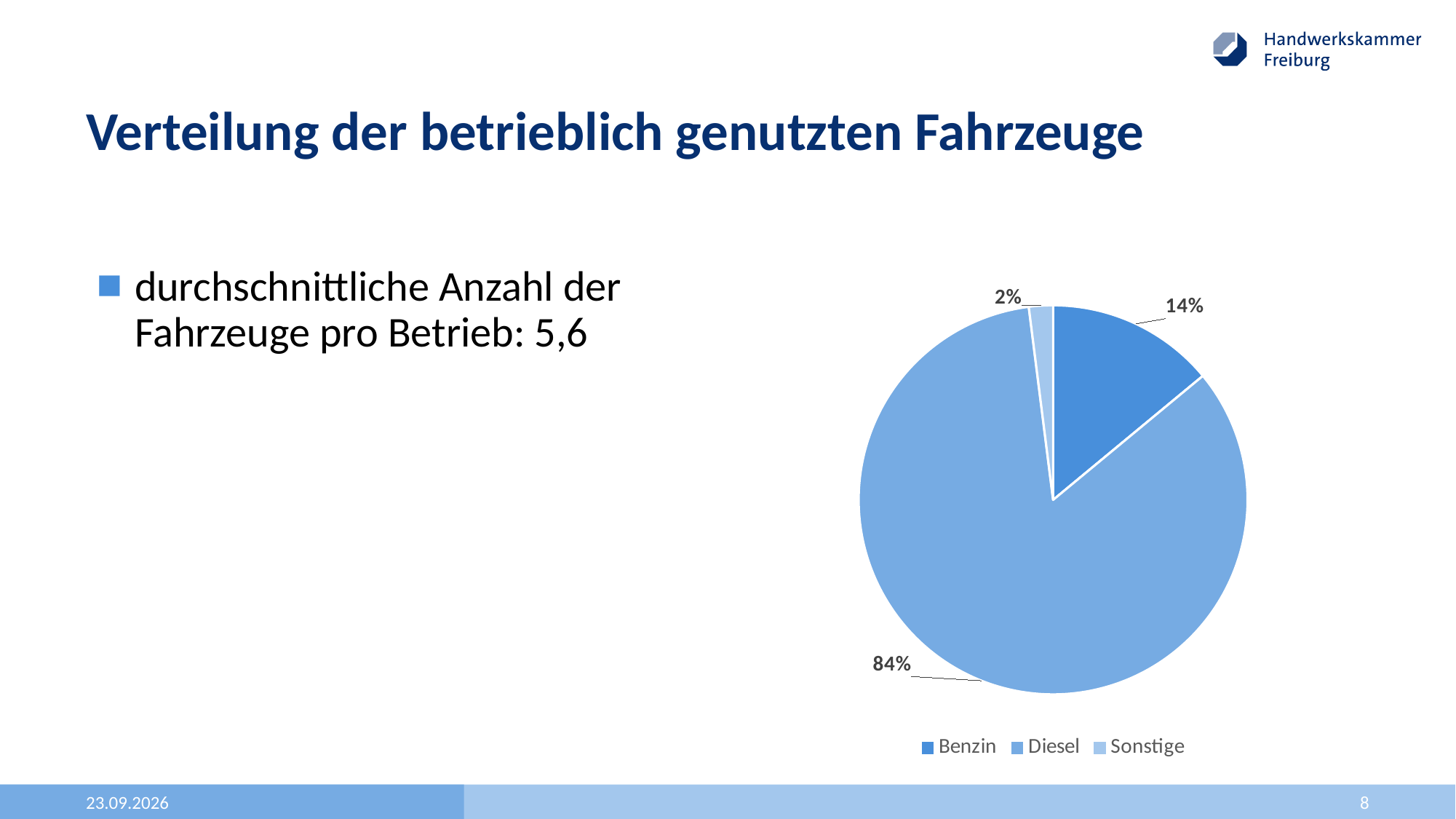
How many categories does the pie chart show? 3 What share of the pie does Benzin account for? 14% What are the three legend entries of the chart? Benzin, Diesel, Sonstige Which category has the smallest slice of the pie? Sonstige What kind of chart is shown on the slide? Pie chart What is the difference in percentage points between the Diesel and Benzin slices? 70 Which category has the largest slice of the pie? Diesel Which slice is larger, Benzin or Sonstige? Benzin What share of the pie does Diesel account for? 84% What is the combined share of Benzin and Sonstige? 16% What is the title of the slide containing the chart? Verteilung der betrieblich genutzten Fahrzeuge What share of the pie does Sonstige account for? 2%